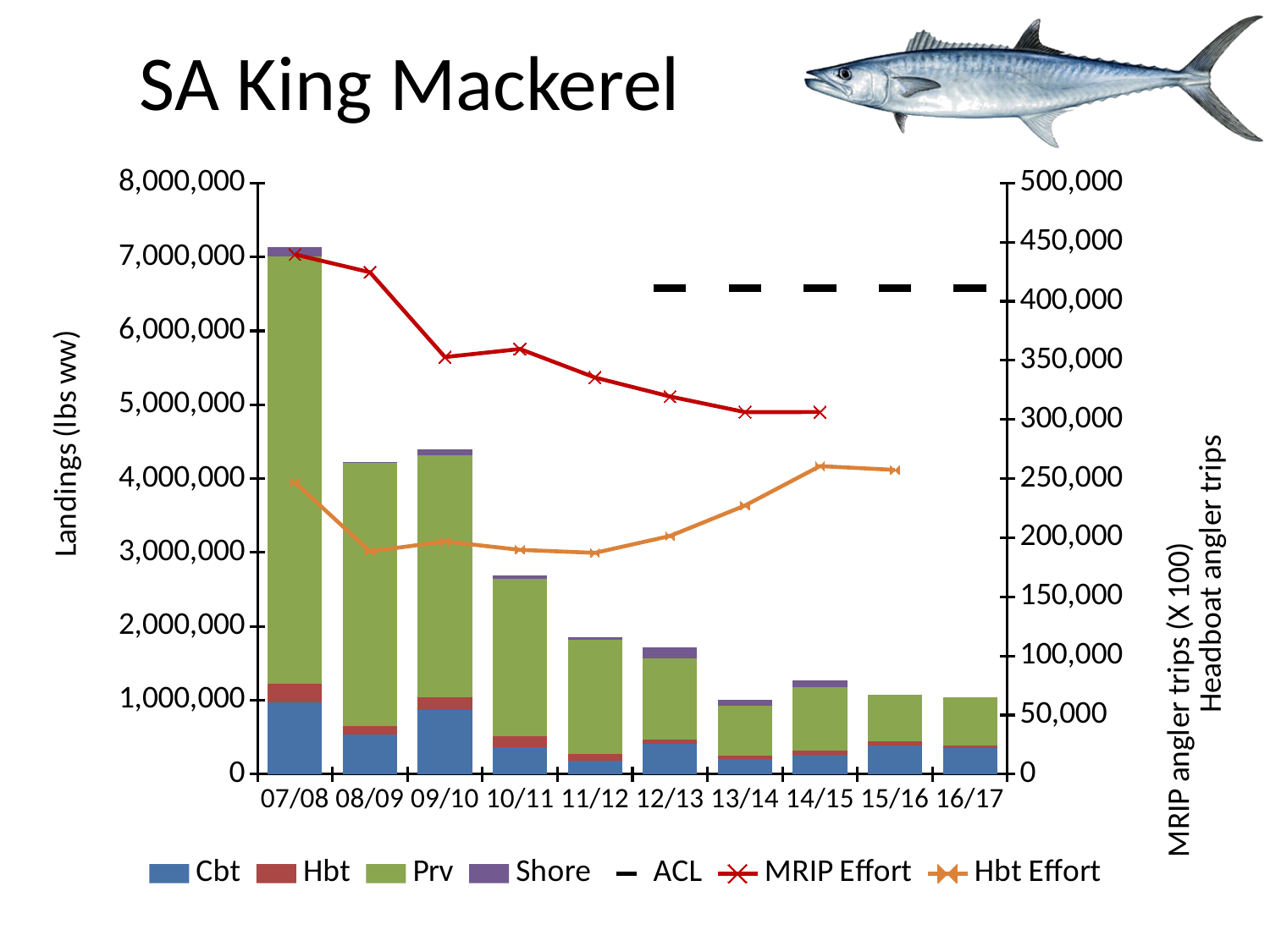
What kind of chart is shown on the slide? A combined stacked bar and line chart Is the MRIP Effort value for 07/08 greater or less than 400,000? greater How many fishing years are shown along the x axis? 10 Does the MRIP Effort line rise or fall from 07/08 to 14/15? fall Which is larger, the total landings for 10/11 or for 11/12? 10/11 Is the total landings value for 07/08 greater or less than 6,000,000? greater How many series does the legend list? 7 Which legend entry is drawn as a black dashed line? ACL Does the Hbt Effort line rise or fall from 11/12 to 14/15? rise Which fishing year has the highest total landings? 07/08 Is the MRIP Effort value for 14/15 greater or less than 350,000? less